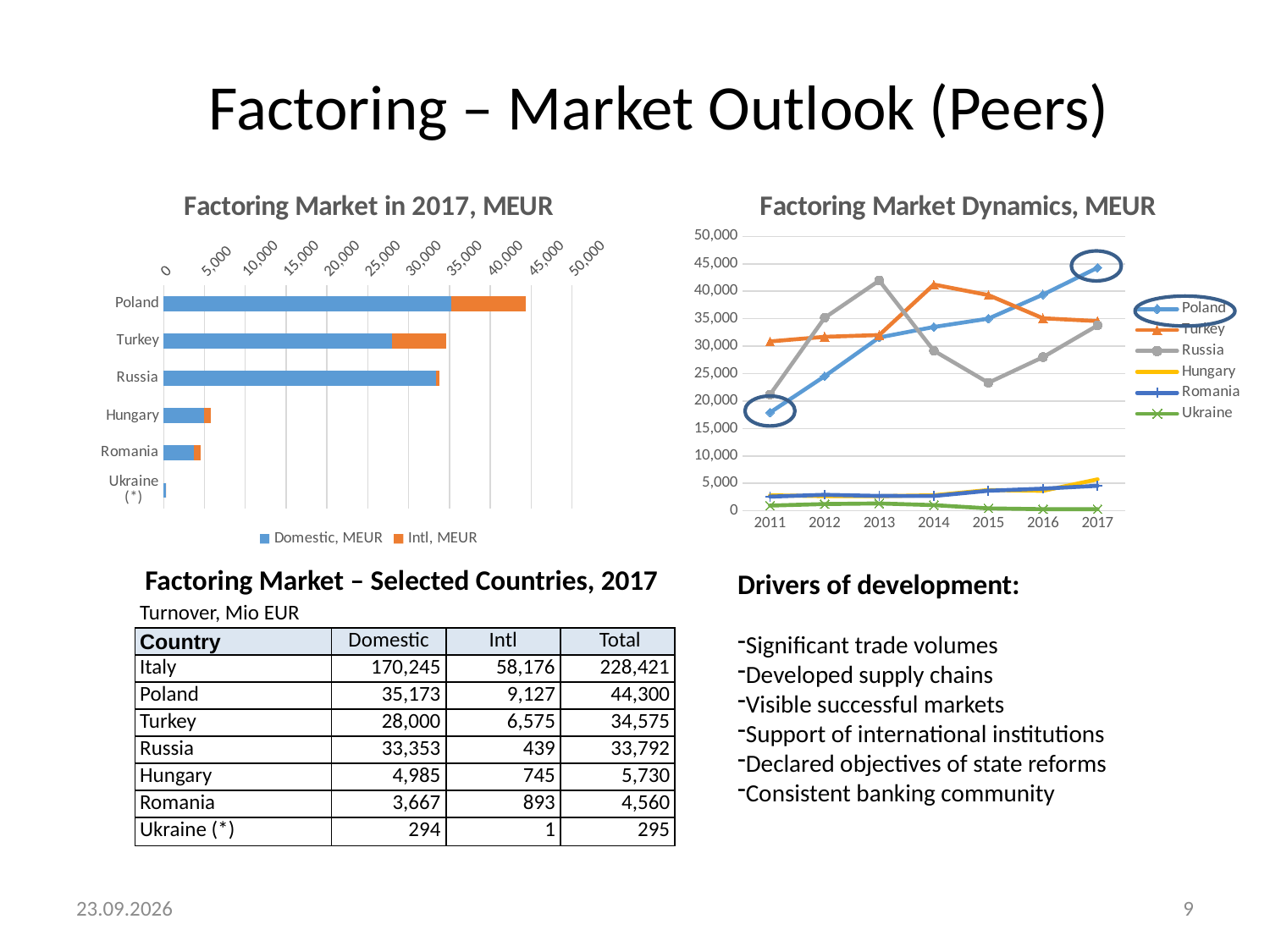
In the "Factoring Market in 2017, MEUR" chart, which country has the longest bar? Poland In the "Factoring Market Dynamics, MEUR" chart, is the value for Russia in 2015 greater or less than 25,000? less In the "Factoring Market in 2017, MEUR" chart, is the Domestic value for Turkey greater or less than 30,000? less In the "Factoring Market in 2017, MEUR" chart, how many countries are shown? 6 In the "Factoring Market in 2017, MEUR" chart, is the Domestic value for Poland greater or less than 30,000? greater In the "Factoring Market Dynamics, MEUR" chart, does the Poland line rise or fall from 2011 to 2017? rise How many series does the legend of the "Factoring Market Dynamics, MEUR" chart list? 6 What kind of chart is "Factoring Market Dynamics, MEUR"? line chart In the "Factoring Market in 2017, MEUR" chart, which country has the shortest bar? Ukraine (*) How many series does the legend of the "Factoring Market in 2017, MEUR" chart list? 2 What kind of chart is "Factoring Market in 2017, MEUR"? bar chart